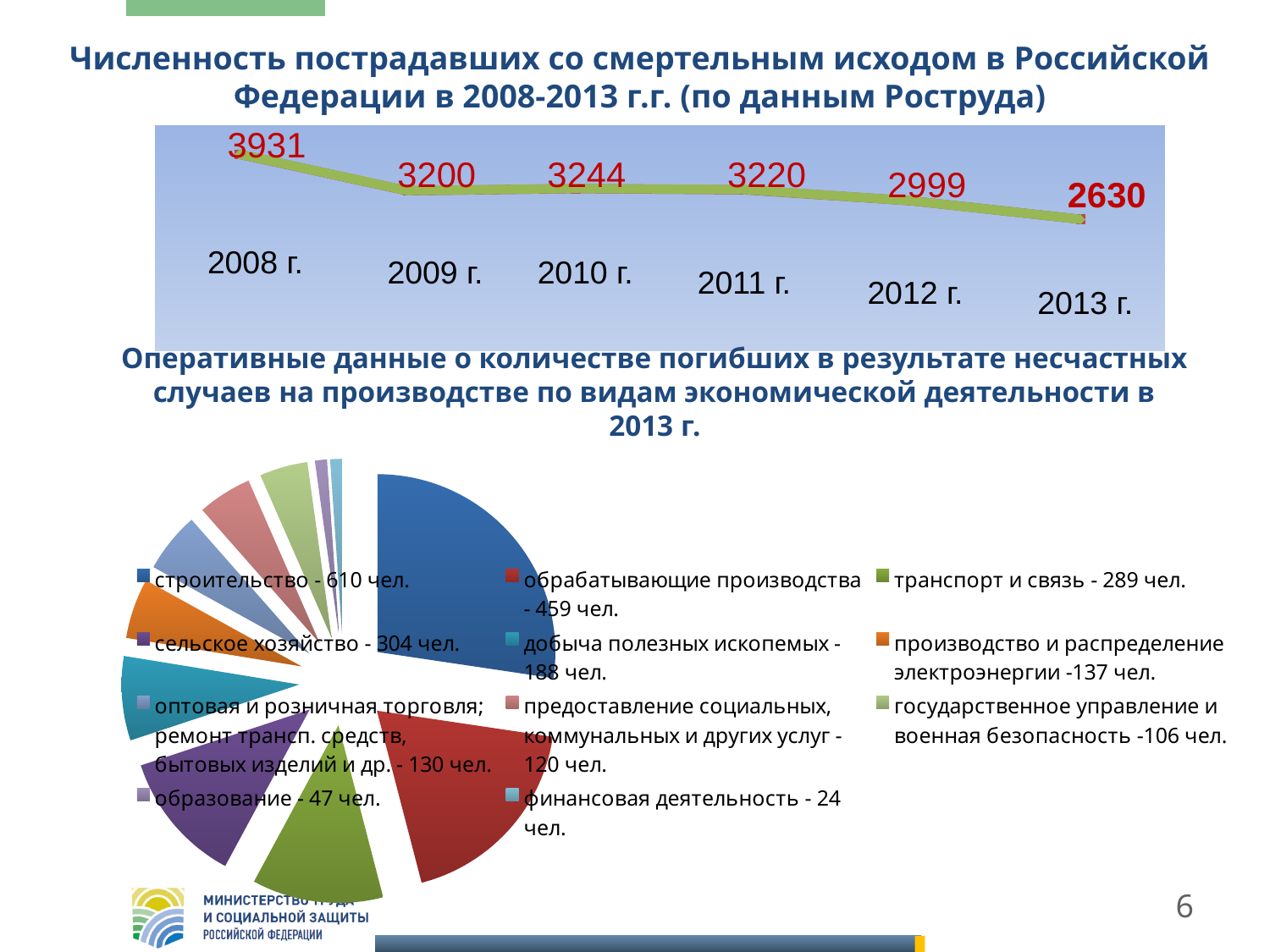
In the bottom pie chart, which category has the smallest value? финансовая деятельность In the top line chart, which year has the highest value? 2008 г. What kind of chart is the bottom chart on the slide? pie chart In the top line chart, what was the number of fatalities in 2013 г.? 2630 In the top line chart, which year has the lowest value? 2013 г. In the bottom pie chart, how many people died in сельское хозяйство? 304 чел. In the top line chart, what was the number of fatalities in 2008 г.? 3931 In the top line chart, how many years are plotted? 6 In the top line chart, which year has the larger value, 2009 г. or 2010 г.? 2010 г. What kind of chart is the top chart on the slide? line chart In the top line chart, what is the difference between the values for 2008 г. and 2013 г.? 1301 In the top line chart, do the values generally rise or fall from 2008 г. to 2013 г.? fall